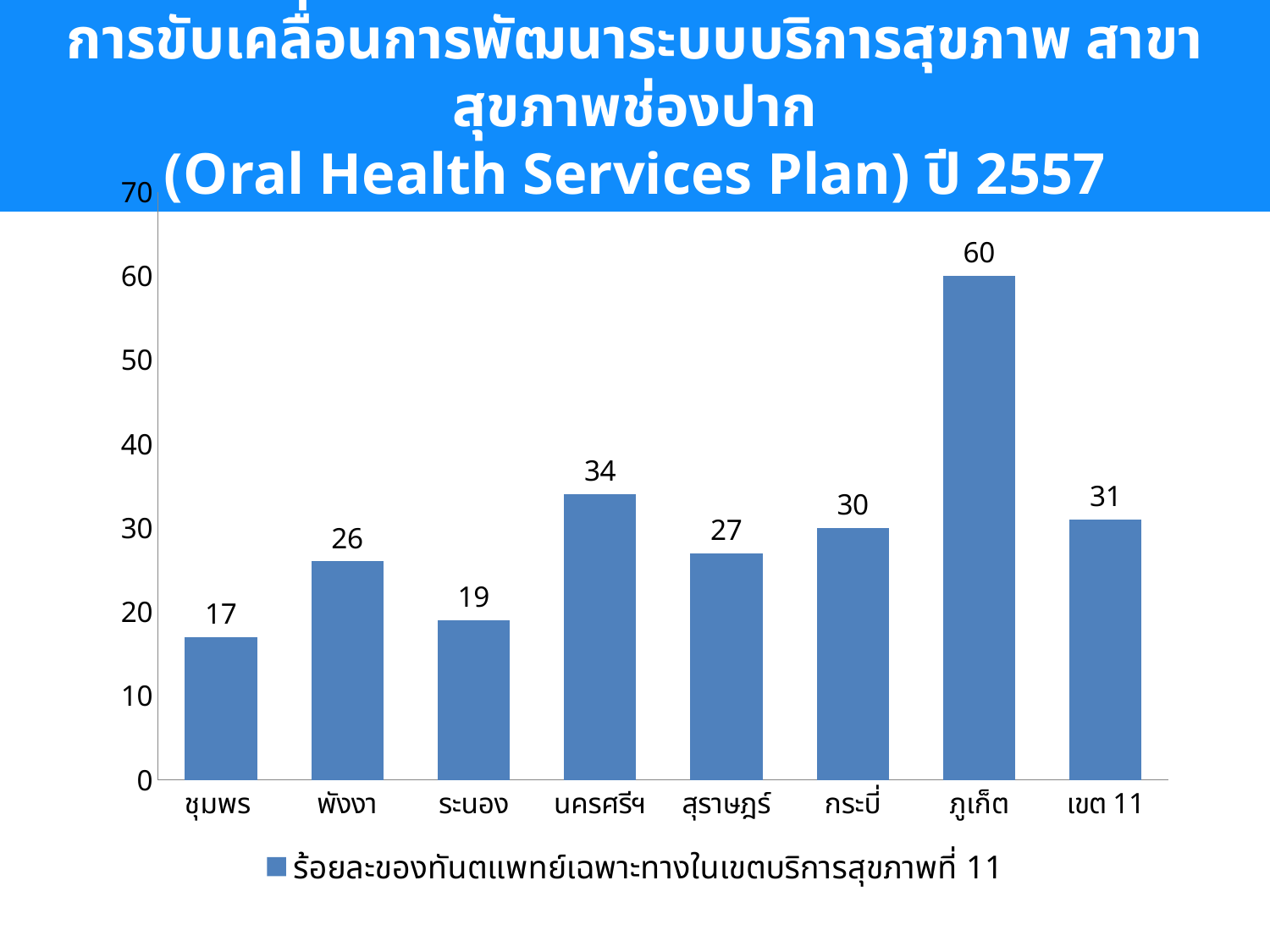
What is the value for ภูเก็ต? 60 Is the value for กระบี่ greater or less than 20? greater What is the value for เขต 11? 31 How many series does the legend list? 1 How many categories are shown on the x axis? 8 What is the legend entry for the series? ร้อยละของทันตแพทย์เฉพาะทางในเขตบริการสุขภาพที่ 11 What kind of chart is shown on the slide? bar chart Which category has the lowest value? ชุมพร Which is larger, the value for พังงา or the value for สุราษฎร์? สุราษฎร์ What is the difference between the values for ภูเก็ต and นครศรีฯ? 26 What is the value for ชุมพร? 17 Which category has the highest value? ภูเก็ต